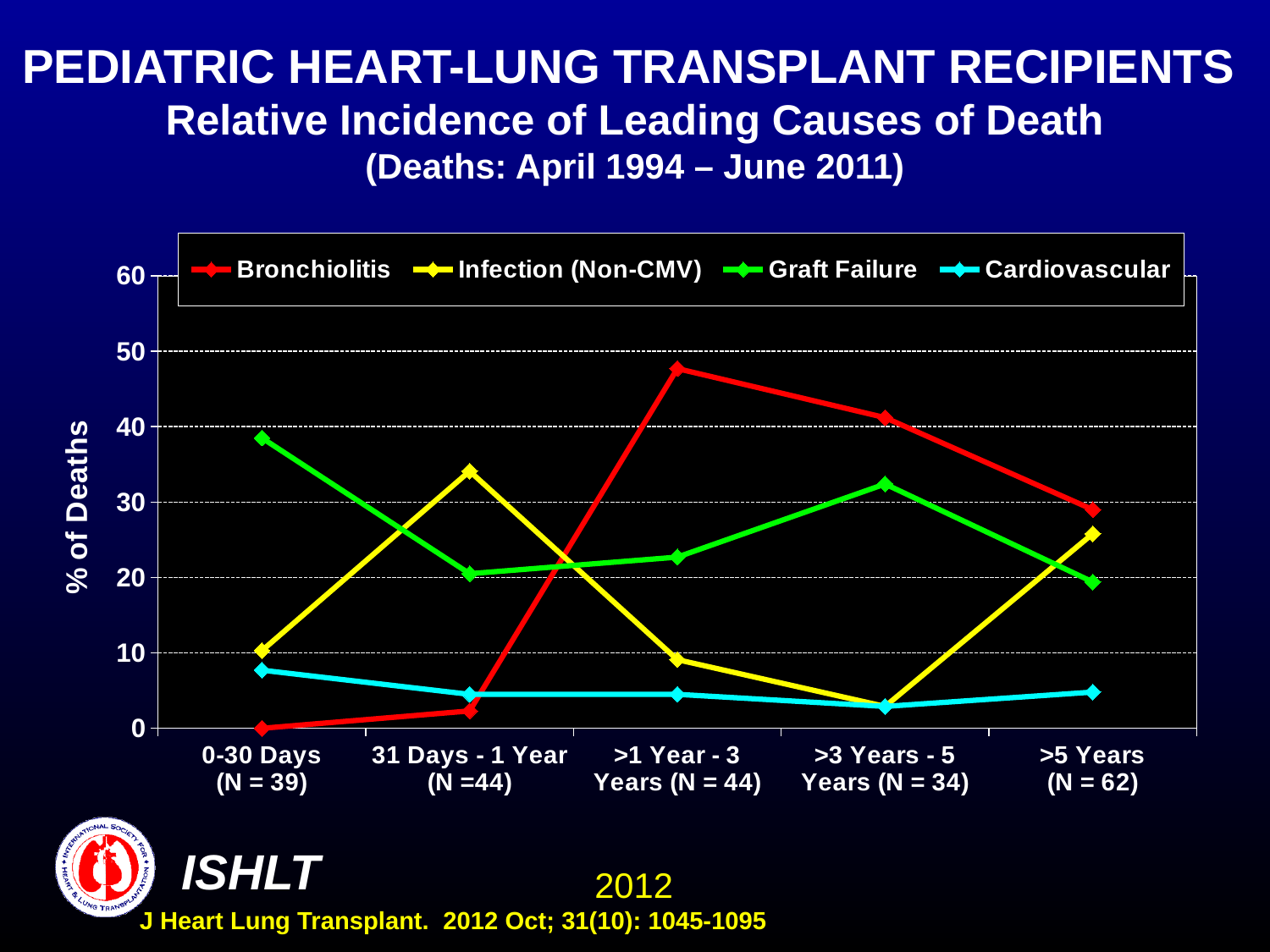
Which cause of death has the highest % of deaths in the >1 Year - 3 Years period? Bronchiolitis What kind of chart is shown on the slide? line chart Does the Bronchiolitis line rise or fall from the >1 Year - 3 Years period to the >5 Years period? fall How many time periods are shown along the x axis? 5 Which cause of death has the highest % of deaths in the 0-30 Days period? Graft Failure How many series does the legend list? 4 Is the value for Bronchiolitis in the >1 Year - 3 Years period greater or less than 40? greater In the >5 Years period, which is larger: Infection (Non-CMV) or Graft Failure? Infection (Non-CMV) What is the label on the y axis? % of Deaths Which cause of death has the lowest % of deaths in the 0-30 Days period? Bronchiolitis Is the value for Infection (Non-CMV) in the 31 Days - 1 Year period greater or less than 30? greater Is the value for Graft Failure in the 0-30 Days period greater or less than 30? greater